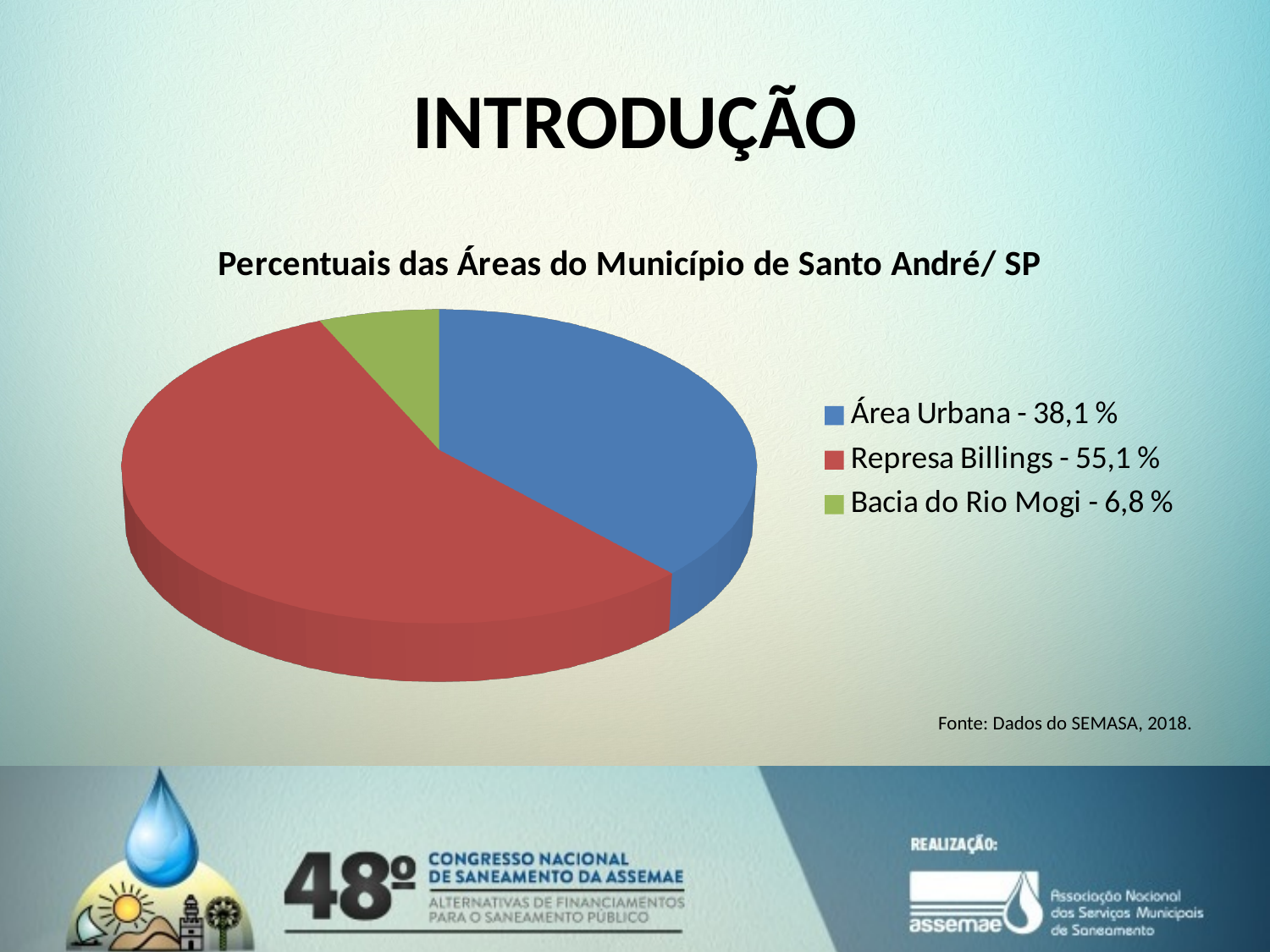
What percentage of the area is Área Urbana? 38,1 % What percentage of the area is Bacia do Rio Mogi? 6,8 % What colour represents Bacia do Rio Mogi in the pie chart? Green Which category has the largest share of the pie? Represa Billings Which is larger, the share for Área Urbana or the share for Represa Billings? Represa Billings Which category has the smallest share of the pie? Bacia do Rio Mogi What is the title of the chart? Percentuais das Áreas do Município de Santo André/ SP What kind of chart is shown on the slide? Pie chart How many categories does the pie chart show? 3 What percentage of the area is Represa Billings? 55,1 % What is the difference in percentage points between Represa Billings and Área Urbana? 17 percentage points What is the combined share of Área Urbana and Bacia do Rio Mogi? 44,9 %